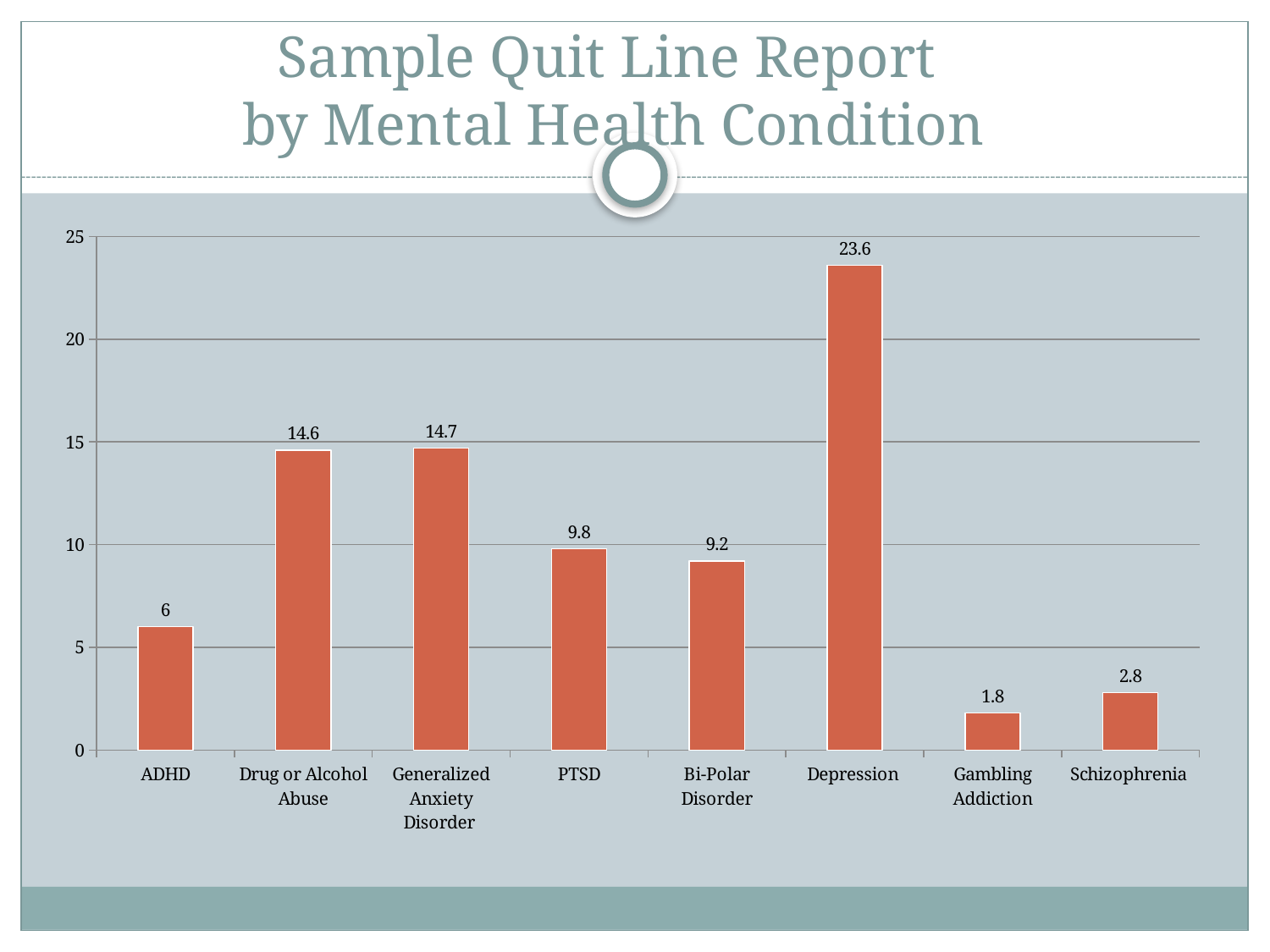
How many categories are shown on the x axis? 8 Which is larger, the value for Schizophrenia or the value for ADHD? ADHD Is the value for Drug or Alcohol Abuse greater or less than 10? greater What kind of chart is shown on the slide? bar chart What is the difference between the values for PTSD and Bi-Polar Disorder? 0.6 What is the difference between the values for Depression and ADHD? 17.6 What is the value for PTSD? 9.8 What is the value for Depression? 23.6 What is the title of the slide? Sample Quit Line Report by Mental Health Condition Which category has the highest value? Depression Which category has the lowest value? Gambling Addiction What is the value for Gambling Addiction? 1.8